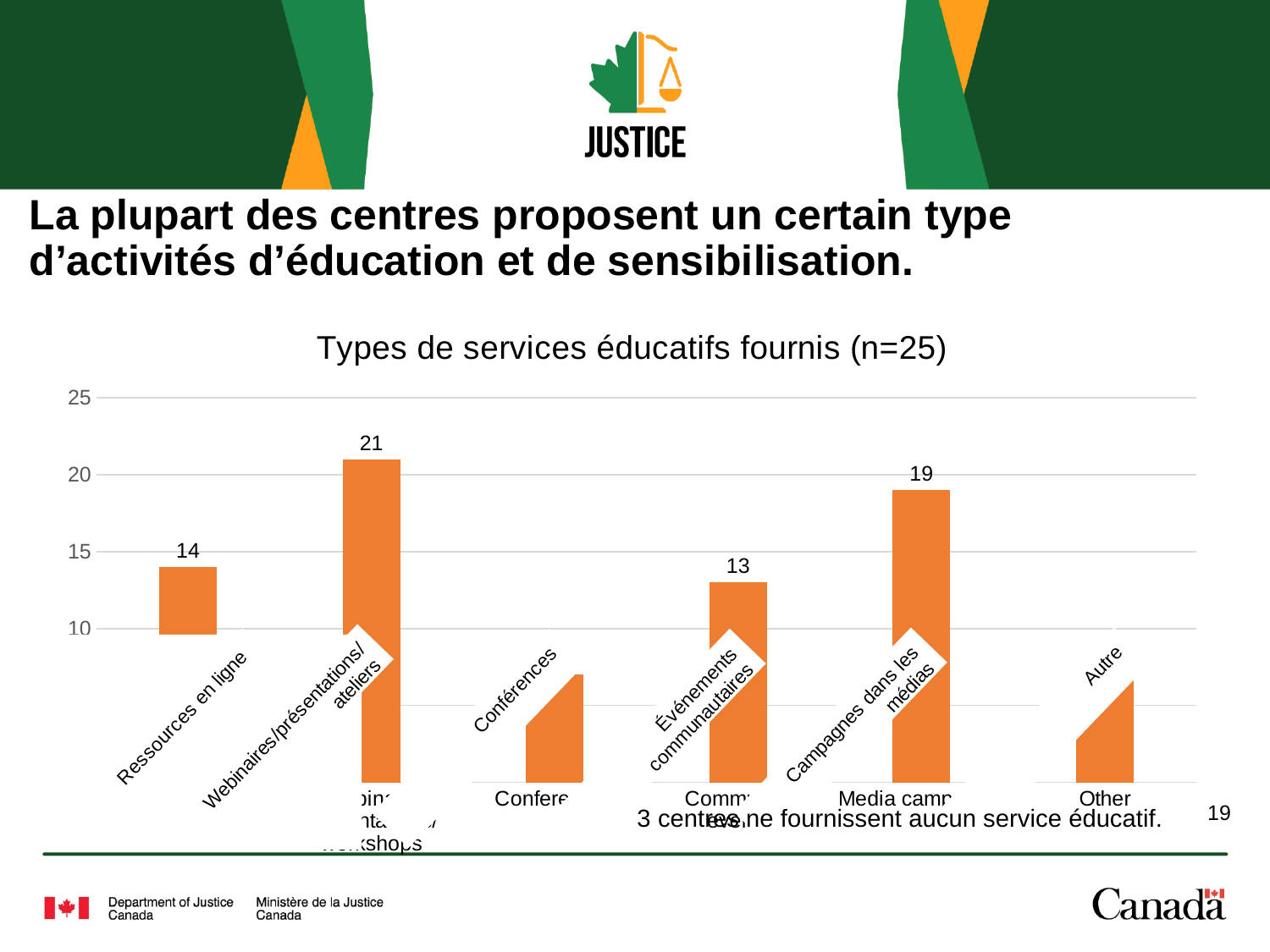
How many categories are shown in the chart? 6 What is the value for Webinaires/présentations/ateliers? 21 What is the value for Ressources en ligne? 14 Is the value for Conférences greater or less than 10? less What is the difference between Campagnes dans les médias and Événements communautaires? 6 What is the value for Campagnes dans les médias? 19 What kind of chart is shown on the slide? Bar chart Which is larger, Campagnes dans les médias or Ressources en ligne? Campagnes dans les médias Is the value for Autre greater or less than 10? less What is the value for Événements communautaires? 13 What is the difference between Webinaires/présentations/ateliers and Ressources en ligne? 7 Which category has the highest value? Webinaires/présentations/ateliers